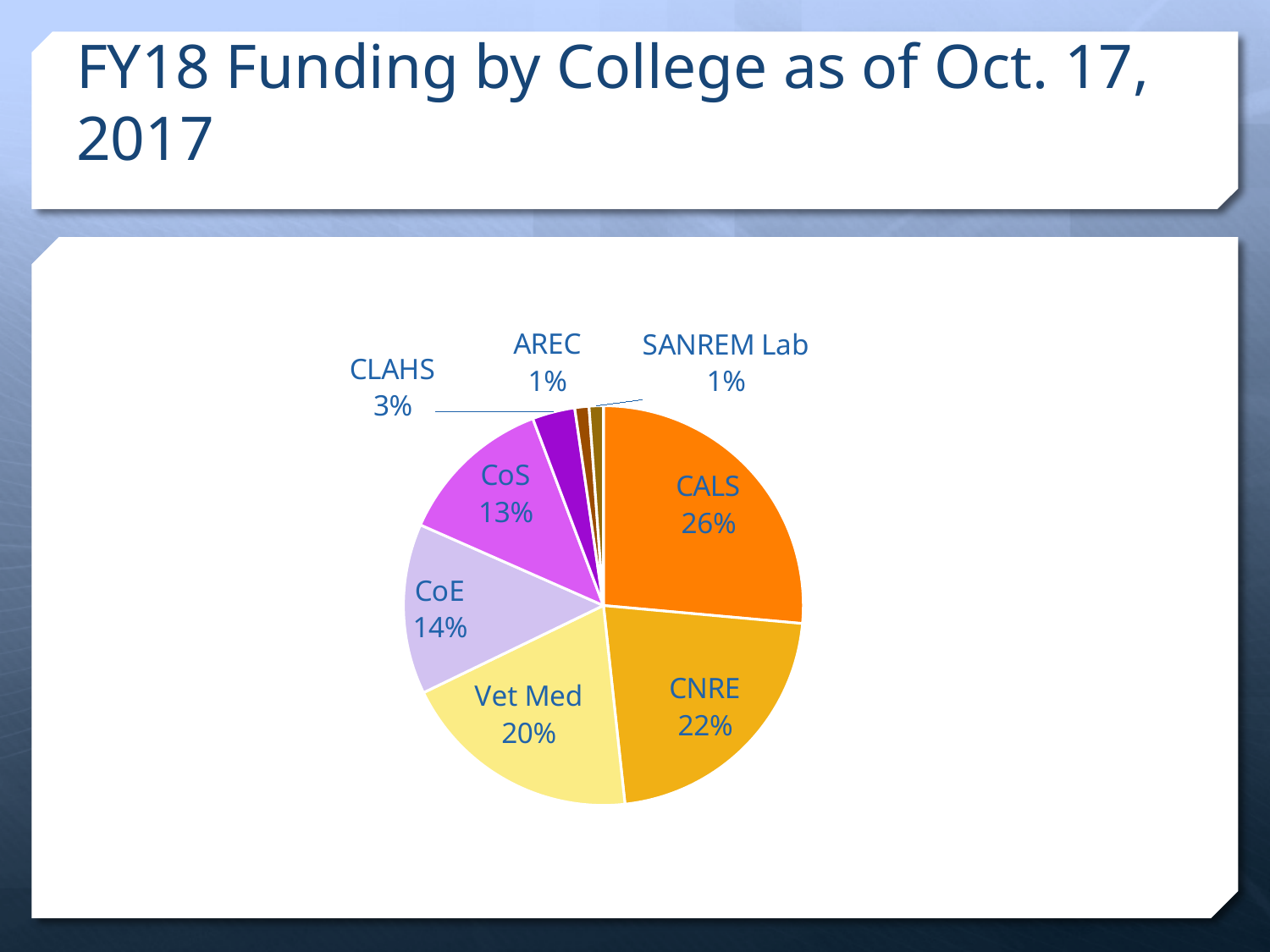
Which two categories each have a 1% share? AREC and SANREM Lab What share is shown for CoE? 14% How many slices does the pie chart have? 8 Which college has the largest share of FY18 funding? CALS Which slice is larger, CNRE or CoS? CNRE What is the difference between the Vet Med share and the CoE share? 6% What percentage of the pie is labelled for Vet Med? 20% What is the title of the slide containing the chart? FY18 Funding by College as of Oct. 17, 2017 What is the difference in percentage points between CALS and CNRE? 4% What type of chart is shown on the slide? Pie chart What percentage is shown for CLAHS? 3% What share of FY18 funding does CALS receive? 26%